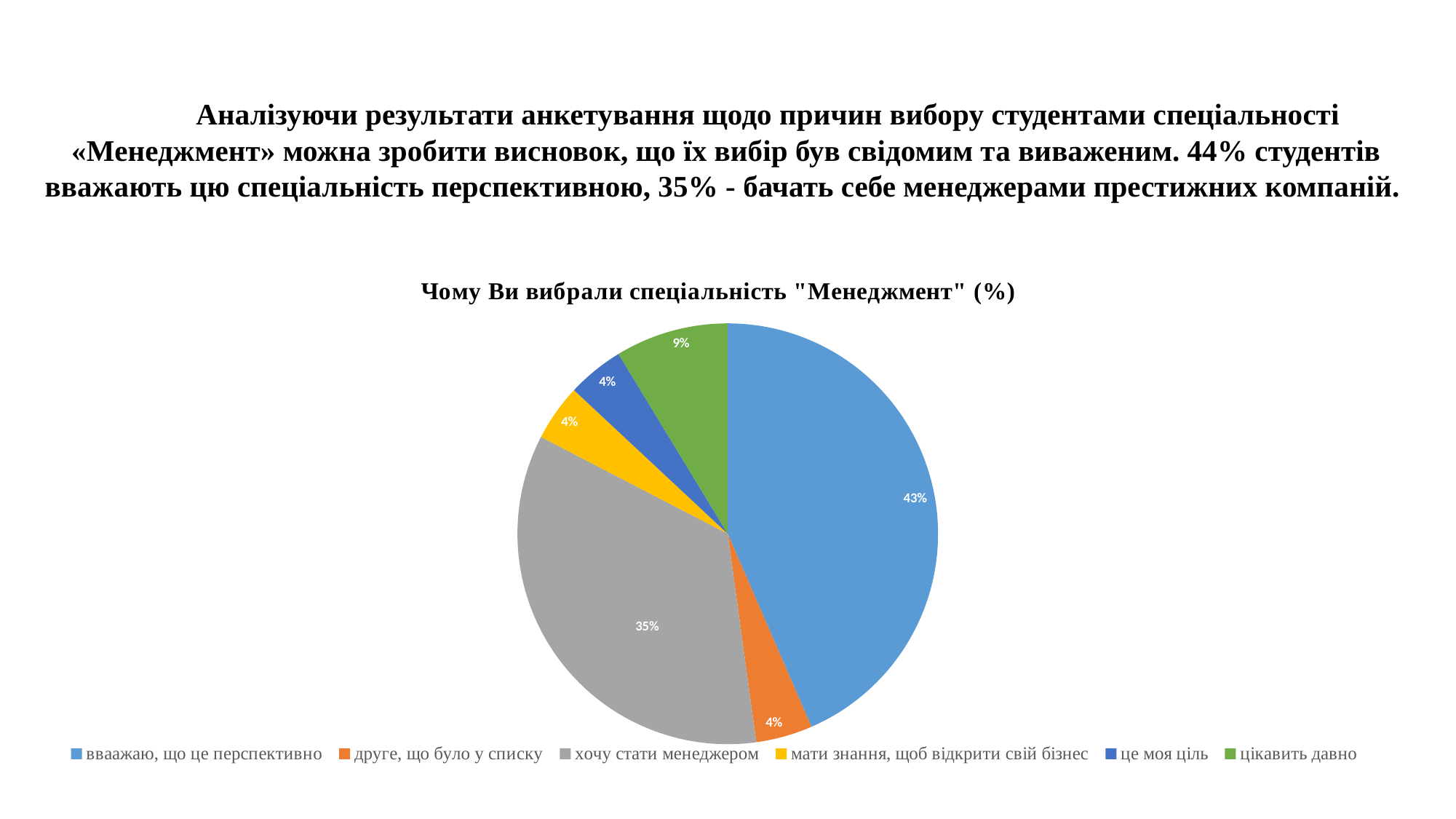
What type of chart is shown on the slide? pie chart How many slices does the pie chart have? 6 What percentage of the pie is the slice "цікавить давно"? 9% Which is larger: the share for "цікавить давно" or the share for "мати знання, щоб відкрити свій бізнес"? цікавить давно What percentage of the pie is the slice "вваажаю, що це перспективно"? 43% What is the difference in percentage points between "вваажаю, що це перспективно" and "хочу стати менеджером"? 8 What colour is the slice for "хочу стати менеджером"? gray What percentage of the pie is the slice "друге, що було у списку"? 4% What percentage of the pie is the slice "хочу стати менеджером"? 35% What is the title of the chart? Чому Ви вибрали спеціальність "Менеджмент" (%) What percentage of the pie is the slice "це моя ціль"? 4% Which category has the largest share of the pie? вваажаю, що це перспективно